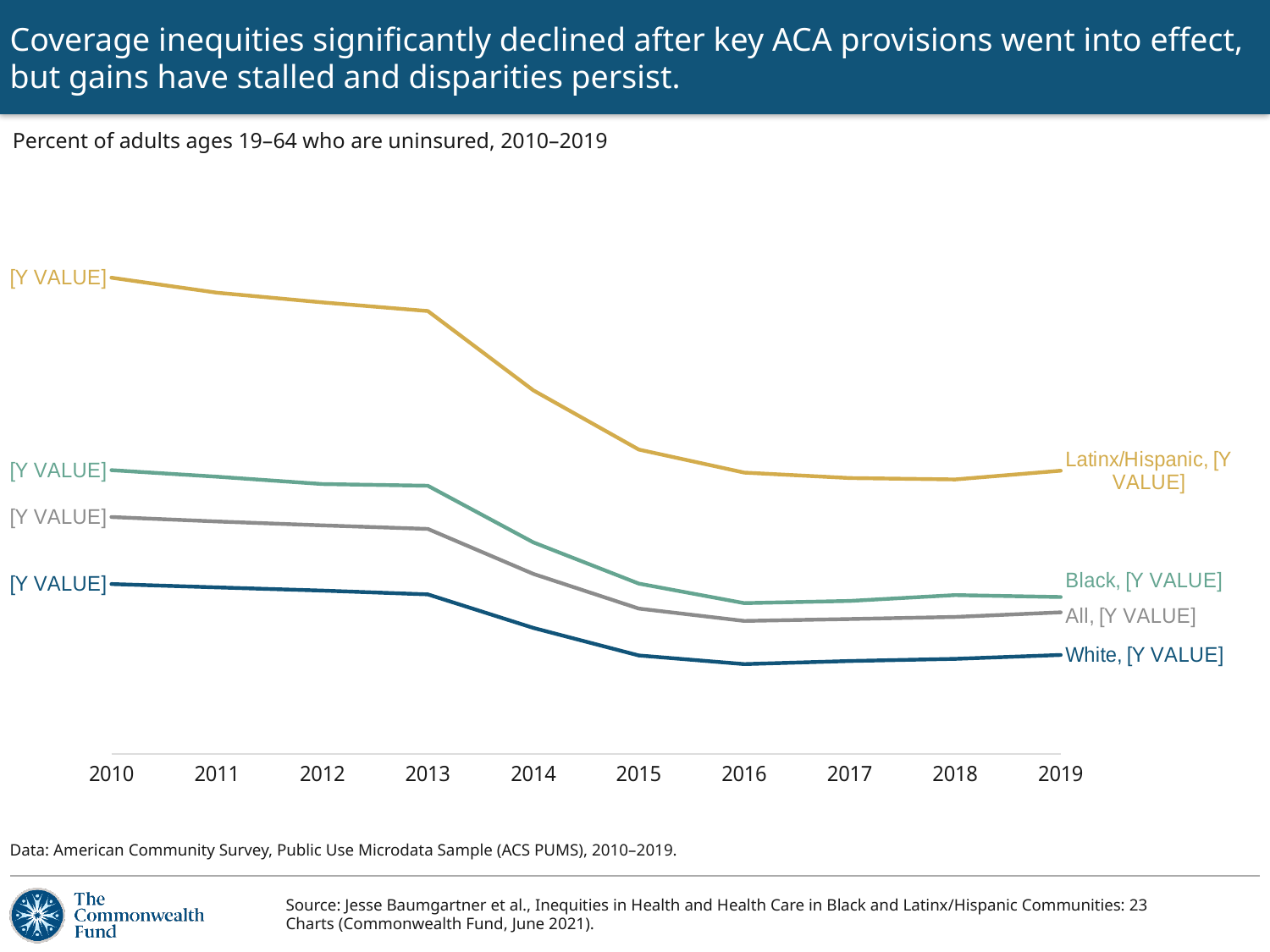
Do the uninsured rates rise or fall between 2013 and 2016? fall How many years are shown along the x axis of the chart? 10 Which group has the highest uninsured rate in 2019? Latinx/Hispanic Which group has the lowest uninsured rate in 2019? White In 2019, is the uninsured rate higher for Black adults or White adults? Black Does the Latinx/Hispanic line rise or fall between 2010 and 2013? fall How many lines (series) are plotted on the chart? 4 In 2016, is the uninsured rate higher for the All line or the Latinx/Hispanic line? Latinx/Hispanic What kind of chart is shown on the slide? line chart What colour is the Latinx/Hispanic line? yellow Which group has the highest uninsured rate in 2010? Latinx/Hispanic What does the chart measure, according to the subtitle? Percent of adults ages 19–64 who are uninsured, 2010–2019